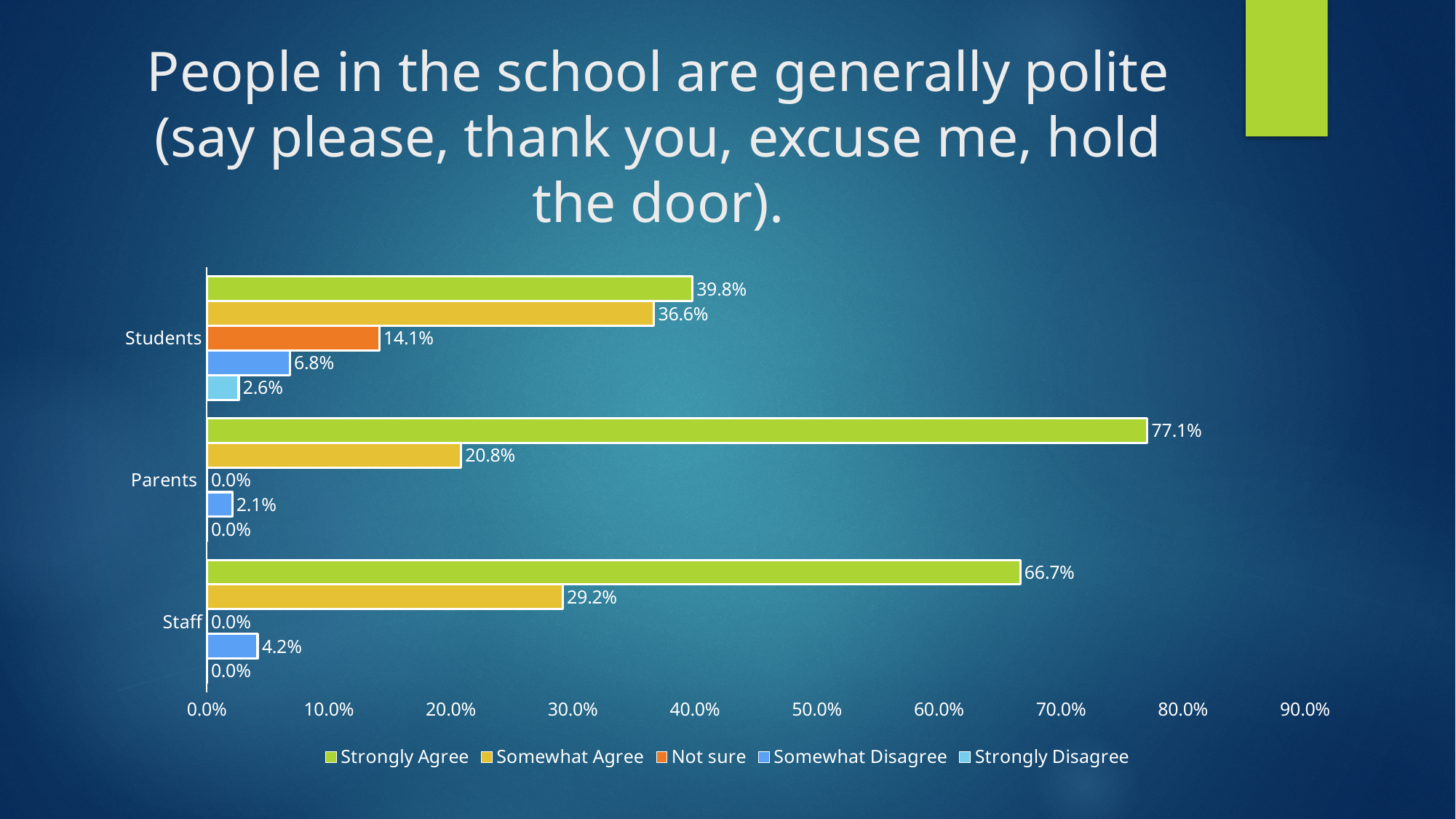
What is the Somewhat Agree value for Parents? 20.8% What kind of chart is shown on the slide? Bar chart What is the Not sure value for Students? 14.1% Which group has the lowest Strongly Agree percentage? Students Which group has the highest Strongly Agree percentage? Parents What is the difference between the Strongly Agree values for Parents and Staff? 10.4% Which legend entry is shown in orange? Not sure How many groups are shown on the vertical axis? 3 What is the Somewhat Disagree value for Staff? 4.2% How many series does the legend list? 5 Which is larger: the Somewhat Agree value for Students or for Staff? Students What percentage of Students Strongly Agree that people in the school are generally polite? 39.8%